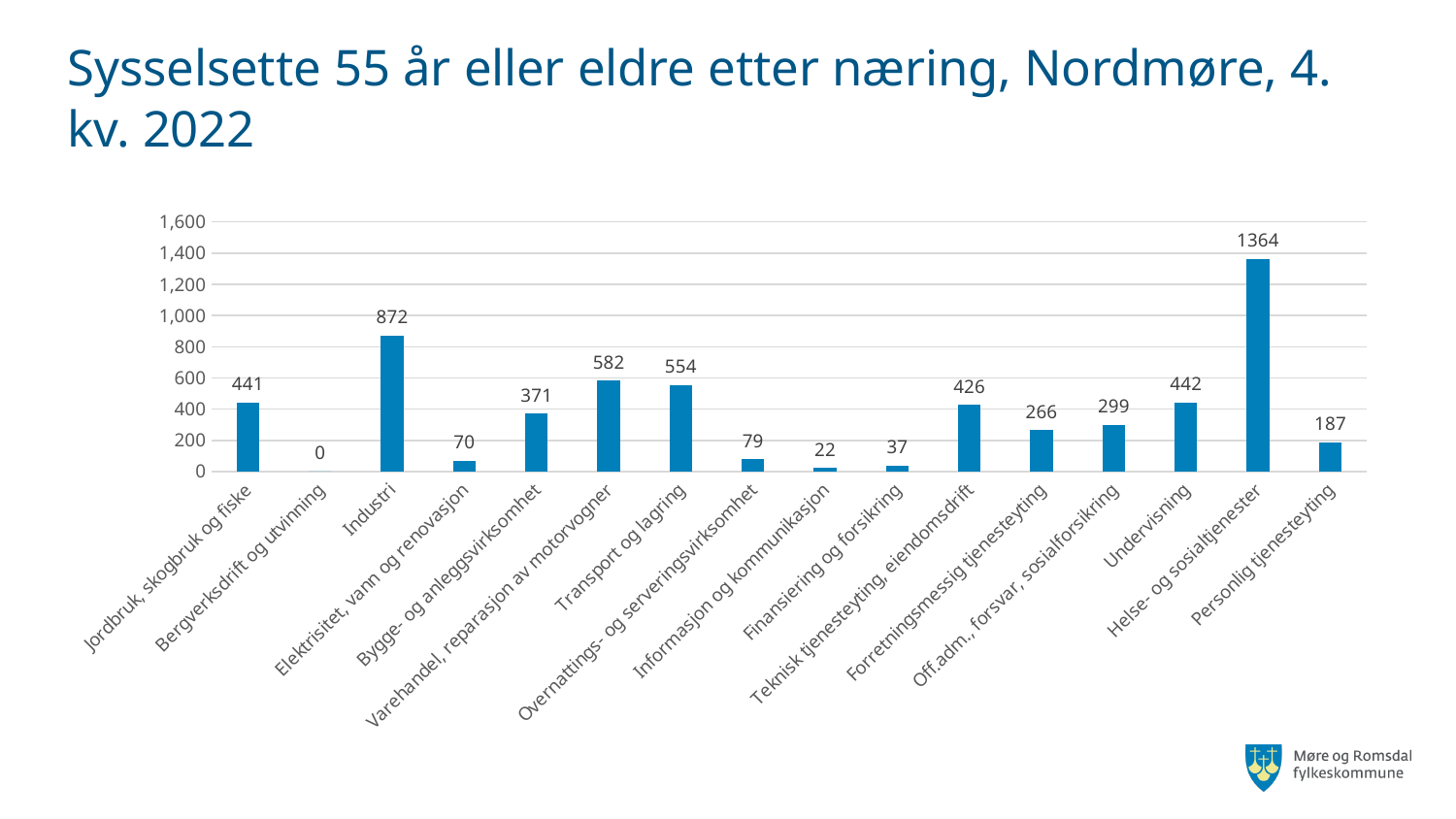
What is the value for Industri? 872 What type of chart is shown on the slide? Bar chart What is the title of the chart? Sysselsette 55 år eller eldre etter næring, Nordmøre, 4. kv. 2022 What is the difference between the values for Helse- og sosialtjenester and Industri? 492 What is the value for Helse- og sosialtjenester? 1364 What is the difference between the values for Undervisning and Jordbruk, skogbruk og fiske? 1 What is the value for Transport og lagring? 554 Which category has the lowest value? Bergverksdrift og utvinning How many categories are shown on the x axis? 16 Which category has the highest value? Helse- og sosialtjenester Which is larger, the value for Varehandel, reparasjon av motorvogner or the value for Transport og lagring? Varehandel, reparasjon av motorvogner What is the value for Bergverksdrift og utvinning? 0